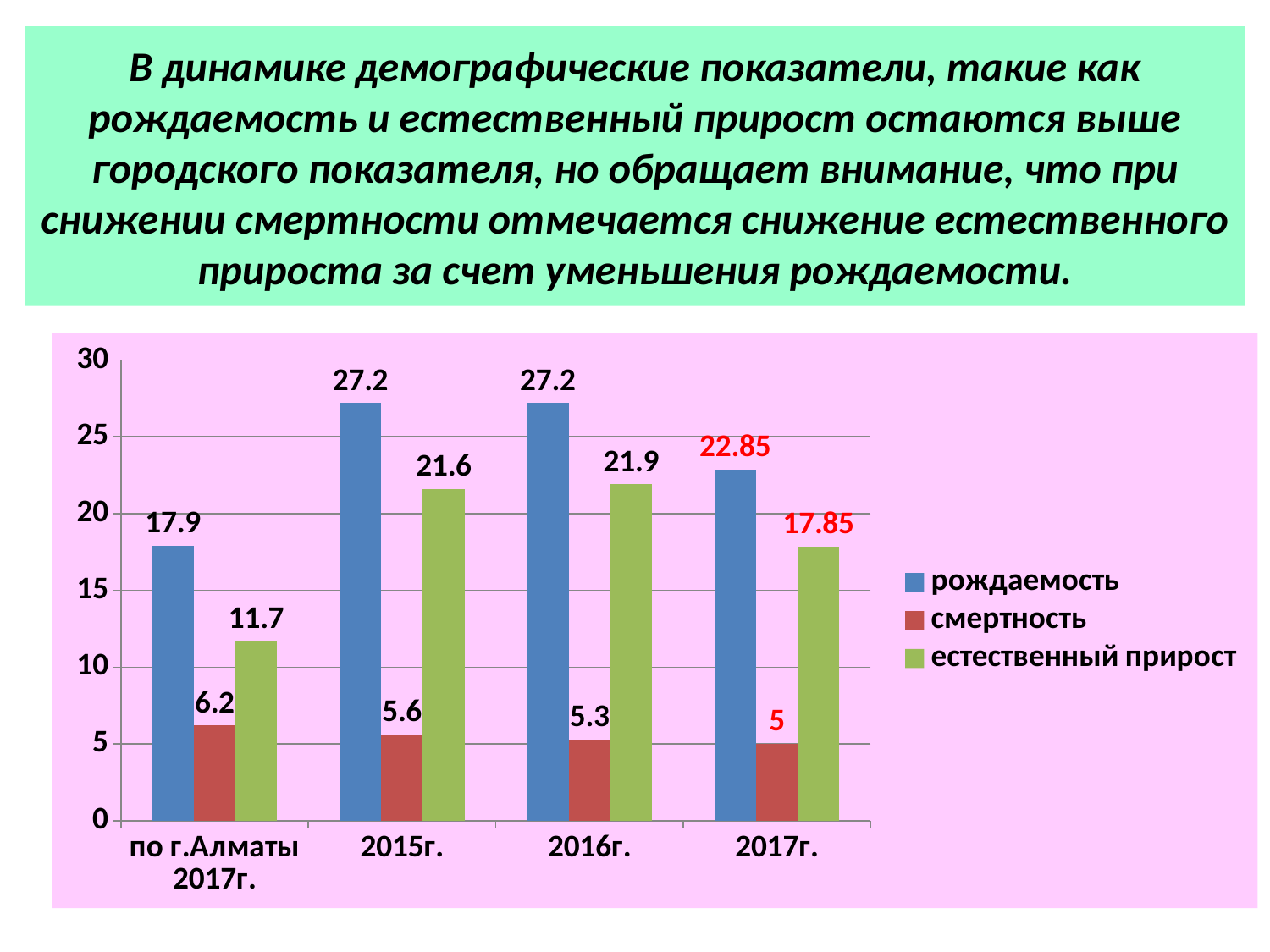
What is the difference between рождаемость and естественный прирост for 2016г.? 5.3 What kind of chart is shown on the slide? bar chart Which category has the lowest value for рождаемость? по г.Алматы 2017г. What is the value of смертность for по г.Алматы 2017г.? 6.2 Which is larger: естественный прирост for 2015г. or for 2016г.? 2016г. Does смертность rise or fall from 2015г. to 2017г.? fall Which category has the lowest value for смертность? 2017г. What is the value of естественный прирост for 2017г.? 17.85 Is the value of рождаемость for 2017г. greater or less than 20? greater How many series does the legend list? 3 What is the value of рождаемость for 2015г.? 27.2 How many categories are shown on the x axis? 4